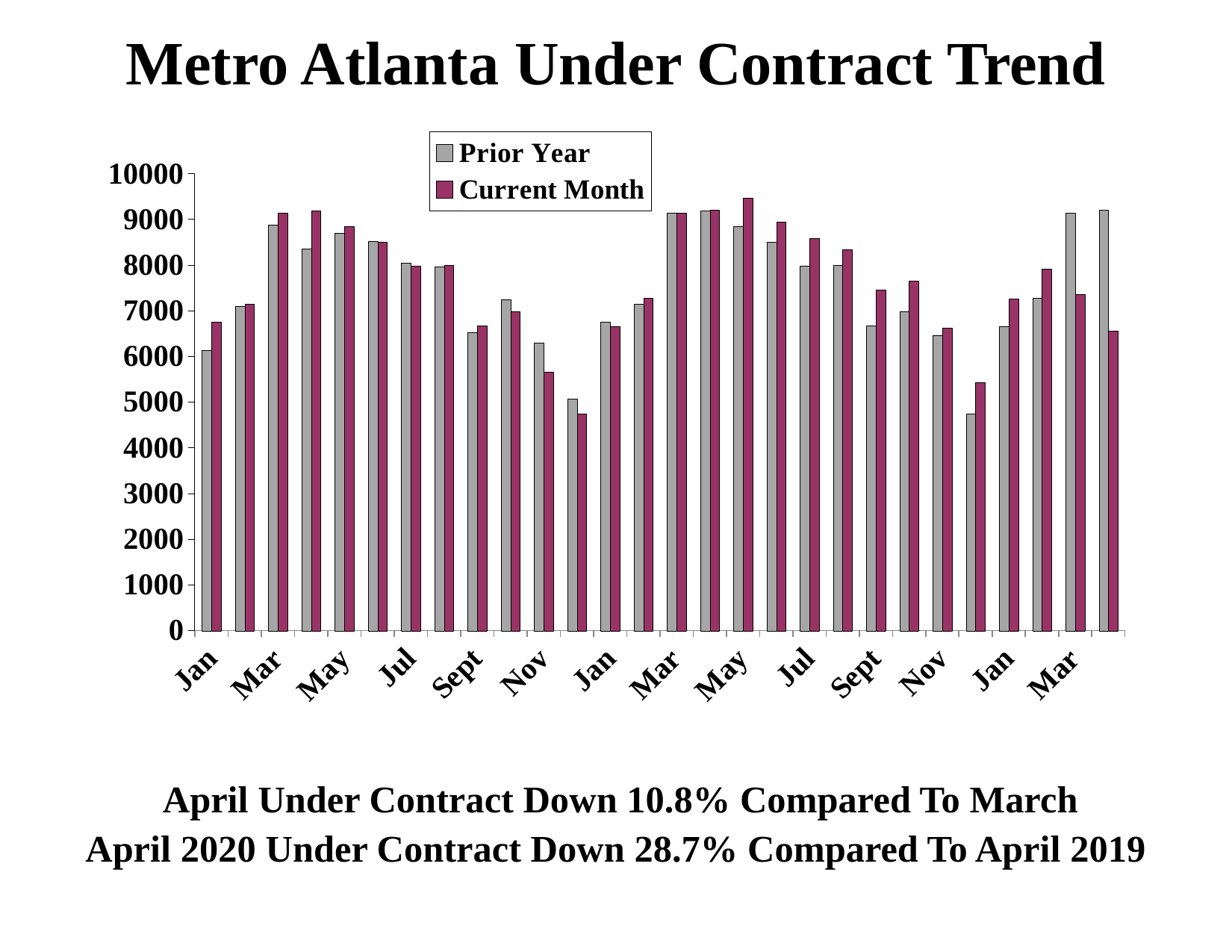
Is the Current Month value for the second Nov on the x axis greater or less than 6000? greater Is the Current Month value for the second May on the x axis greater or less than 9000? greater Is the Prior Year value for the third Jan on the x axis greater or less than 5000? greater What kind of chart is shown on the slide? bar chart How many month labels are shown along the x axis? 14 For the third Jan on the x axis, which is larger: the Prior Year bar or the Current Month bar? Current Month How many series does the legend list? 2 For the last Mar on the x axis, which is larger: the Prior Year bar or the Current Month bar? Prior Year At which x-axis label does the Current Month series reach its highest value? the second May Which series is drawn in the darker (maroon) colour? Current Month What is the title of the chart? Metro Atlanta Under Contract Trend